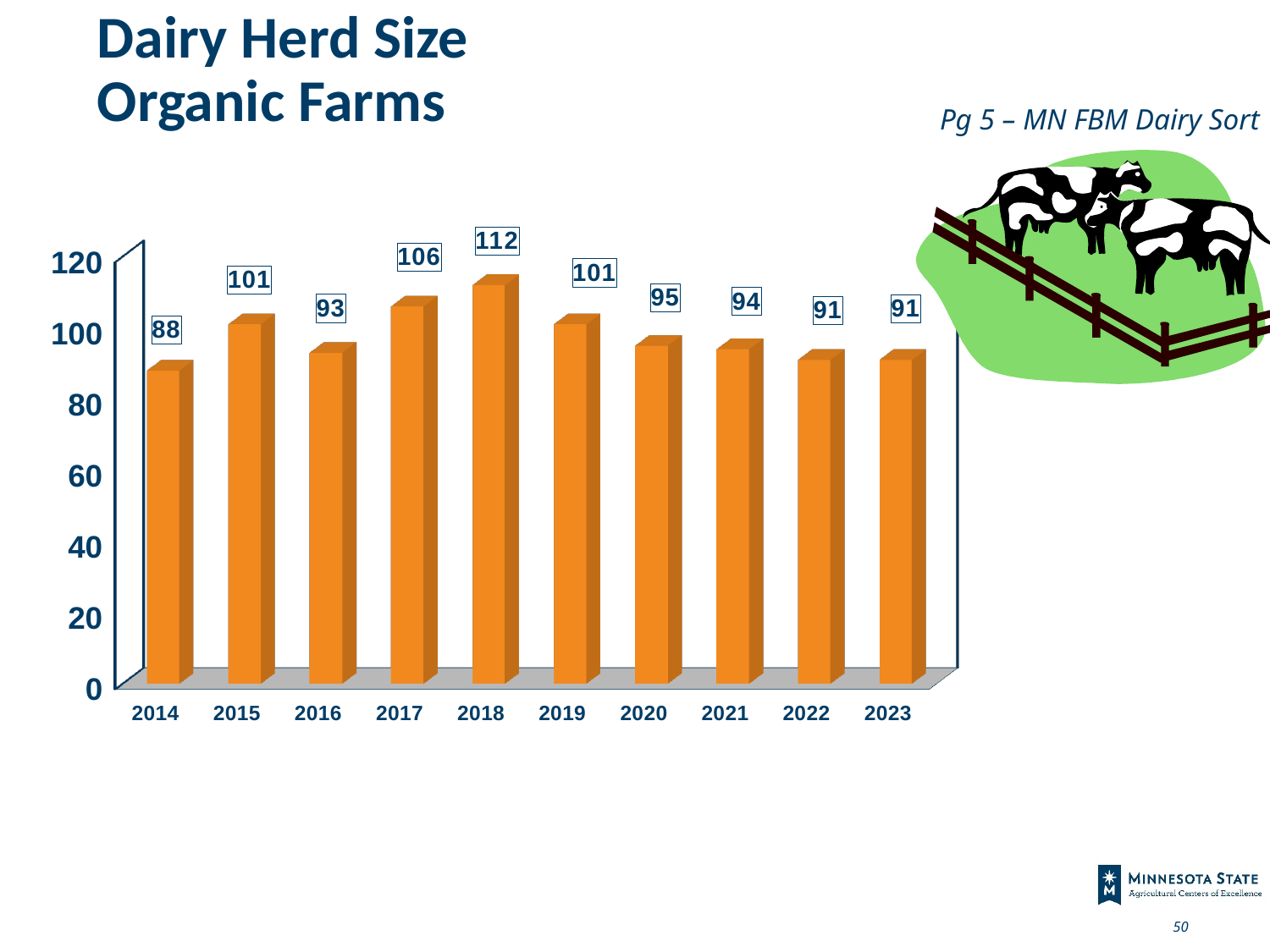
How many years are shown on the chart? 10 Which year had a larger herd size, 2015 or 2020? 2015 Which year had the largest dairy herd size? 2018 What was the dairy herd size for organic farms in 2018? 112 Did the herd size rise or fall from 2018 to 2023? Fall What is the difference in herd size between 2018 and 2014? 24 What was the dairy herd size for organic farms in 2023? 91 What is the difference in herd size between 2017 and 2016? 13 What was the dairy herd size for organic farms in 2014? 88 Which year had the smallest dairy herd size? 2014 What kind of chart is shown on the slide? Bar chart Is the herd size for 2016 greater or less than 100? less